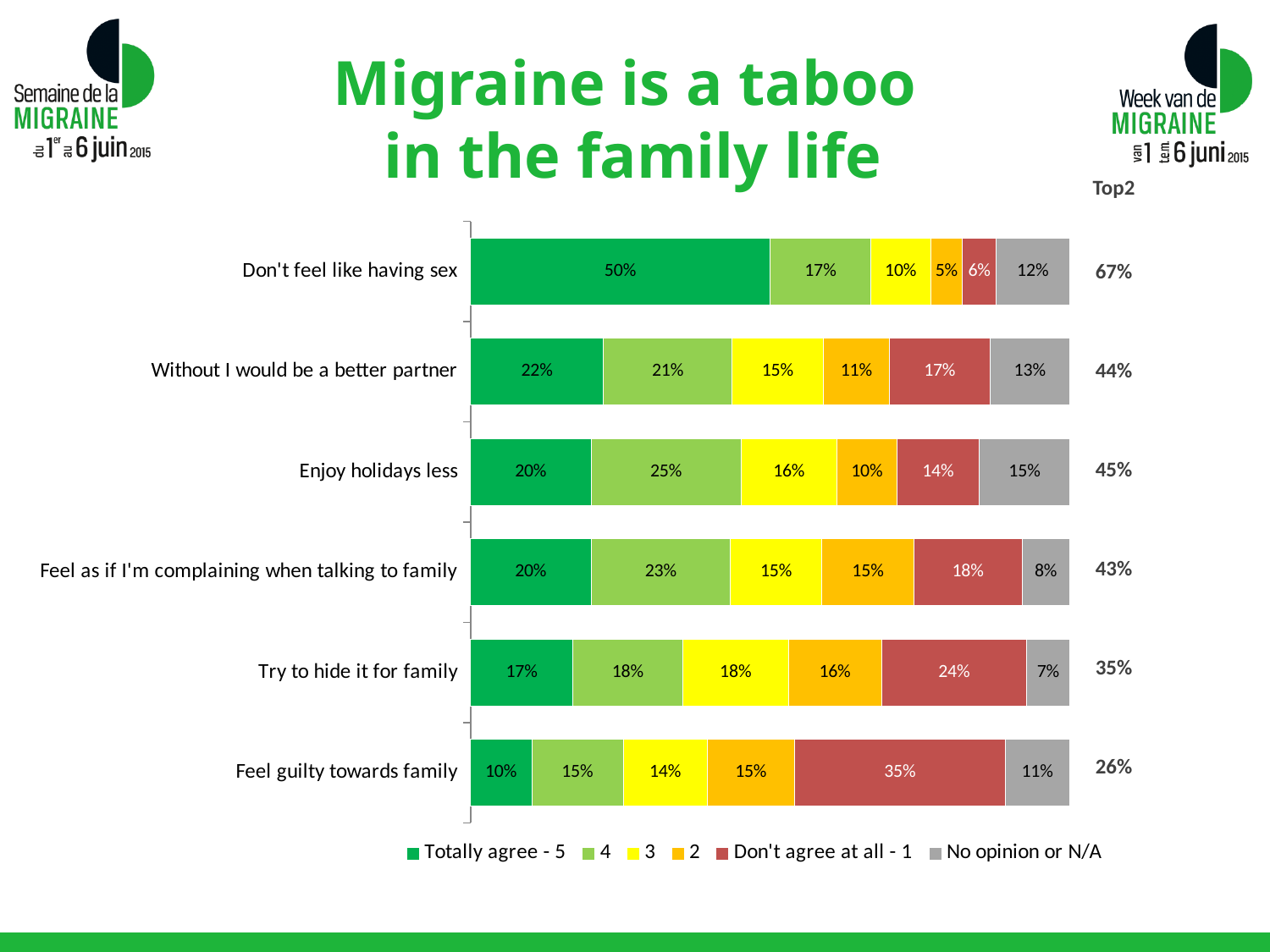
How many statements (categories) are shown in the chart? 6 How many series does the legend list? 6 What is the difference between the "Totally agree - 5" values for "Without I would be a better partner" and "Feel guilty towards family"? 12% What is the Top2 value shown for "Try to hide it for family"? 35% What is the "No opinion or N/A" value for "Enjoy holidays less"? 15% What is the "Don't agree at all - 1" value for "Feel guilty towards family"? 35% What kind of chart is shown on the slide? Stacked bar chart What percentage of respondents totally agree (5) with "Don't feel like having sex"? 50% Which is larger: the "Don't agree at all - 1" value for "Try to hide it for family" or for "Enjoy holidays less"? Try to hide it for family Which statement has the highest "Totally agree - 5" percentage? Don't feel like having sex What is the title of the slide? Migraine is a taboo in the family life Which statement has the lowest Top2 value? Feel guilty towards family